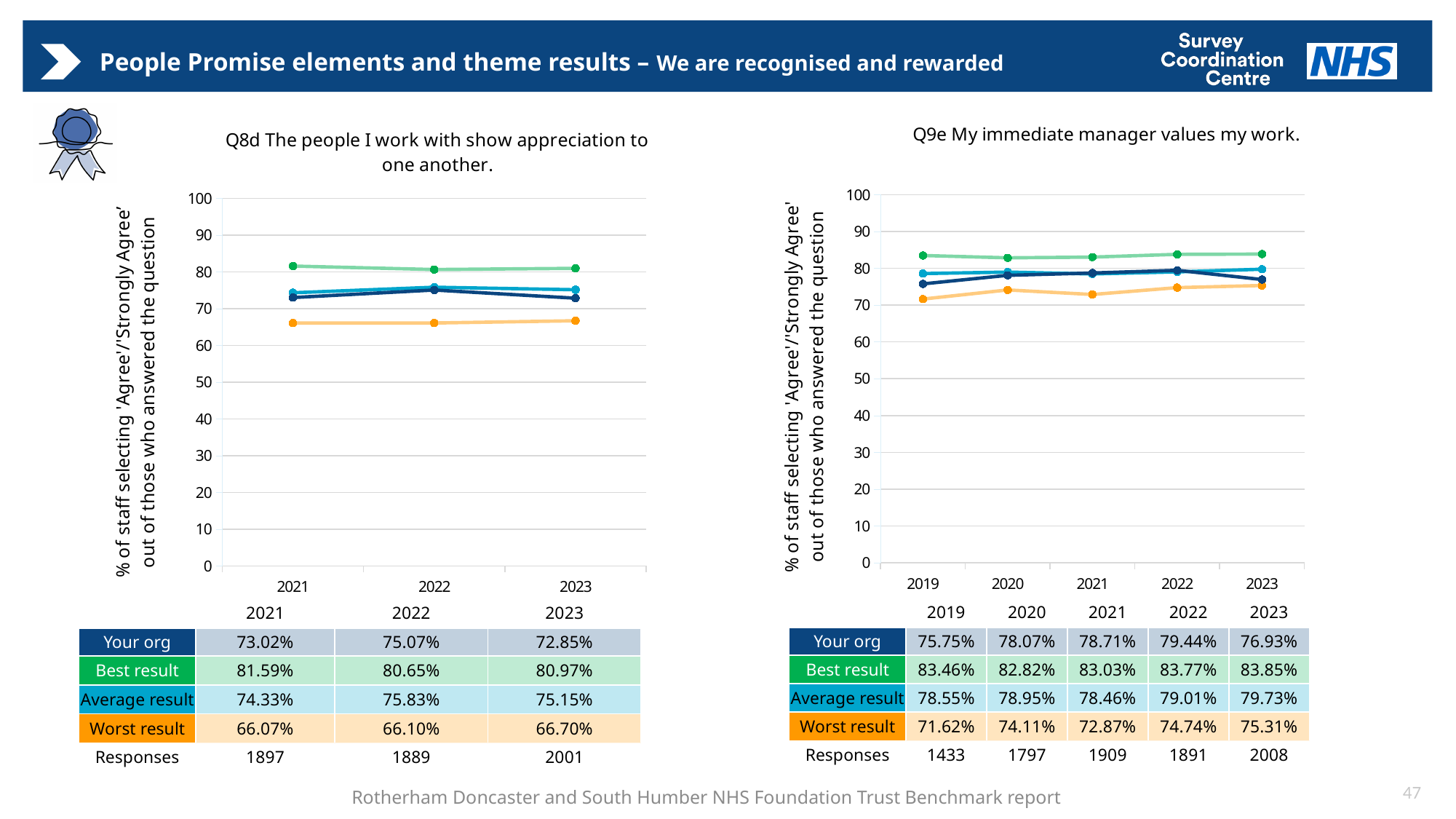
How many years are plotted on the x axis of the Q9e chart (right)? 5 In the Q9e chart (right), in which year is the Worst result value lowest? 2019 In the Q8d chart (left), in which year is the Your org value highest? 2022 In the Q9e chart (right), which is larger in 2022: Your org or Average result? Your org What kind of chart is used for Q8d on the left of the slide? Line chart In the Q8d chart (left), what is the difference between the Best result and Your org values in 2023? 8.12 percentage points In the Q8d chart (left), what is the Your org value for 2022? 75.07% In the Q9e table (right), how many responses were recorded for 2021? 1909 In the Q9e chart (right), does the Your org value rise or fall from 2022 to 2023? fall In the Q9e chart (right), what is the Best result value for 2023? 83.85% How many series are shown in the Q8d chart (left), as listed in the table beneath it? 4 In the Q8d chart (left), is the Worst result value for 2021 greater or less than 70? less